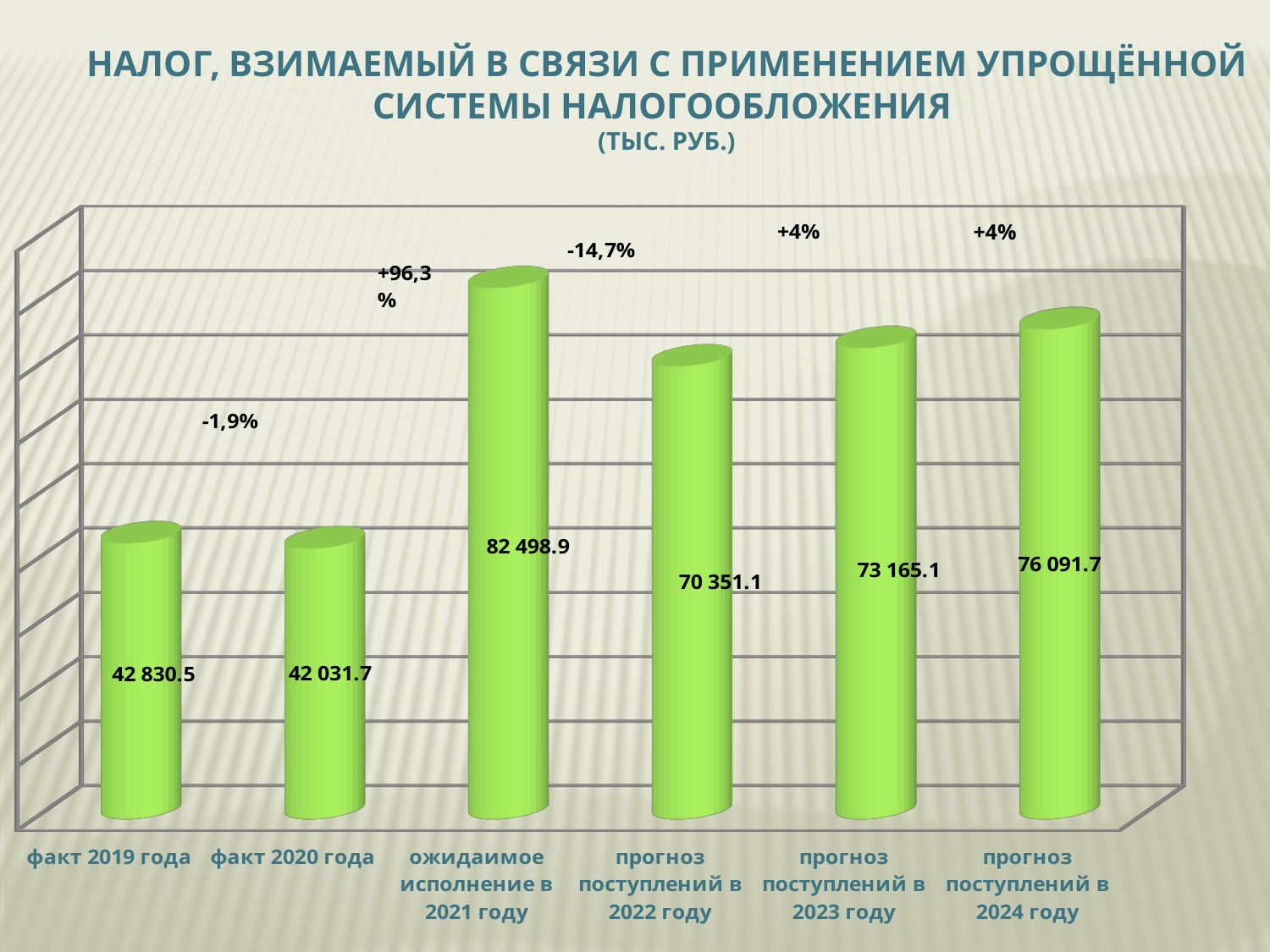
What kind of chart is shown on the slide? bar chart What is the value for факт 2019 года? 42 830.5 Which category has the highest value? ожидаимое исполнение в 2021 году Which is larger, the value for прогноз поступлений в 2023 году or прогноз поступлений в 2022 году? прогноз поступлений в 2023 году What is the value for факт 2020 года? 42 031.7 Which category has the lowest value? факт 2020 года What is the difference between the values for ожидаимое исполнение в 2021 году and прогноз поступлений в 2022 году? 12 147.8 What is the value for ожидаимое исполнение в 2021 году? 82 498.9 What is the difference between the values for прогноз поступлений в 2024 году and прогноз поступлений в 2023 году? 2 926.6 What is the value for прогноз поступлений в 2022 году? 70 351.1 What is the value for прогноз поступлений в 2024 году? 76 091.7 How many categories are shown on the chart? 6